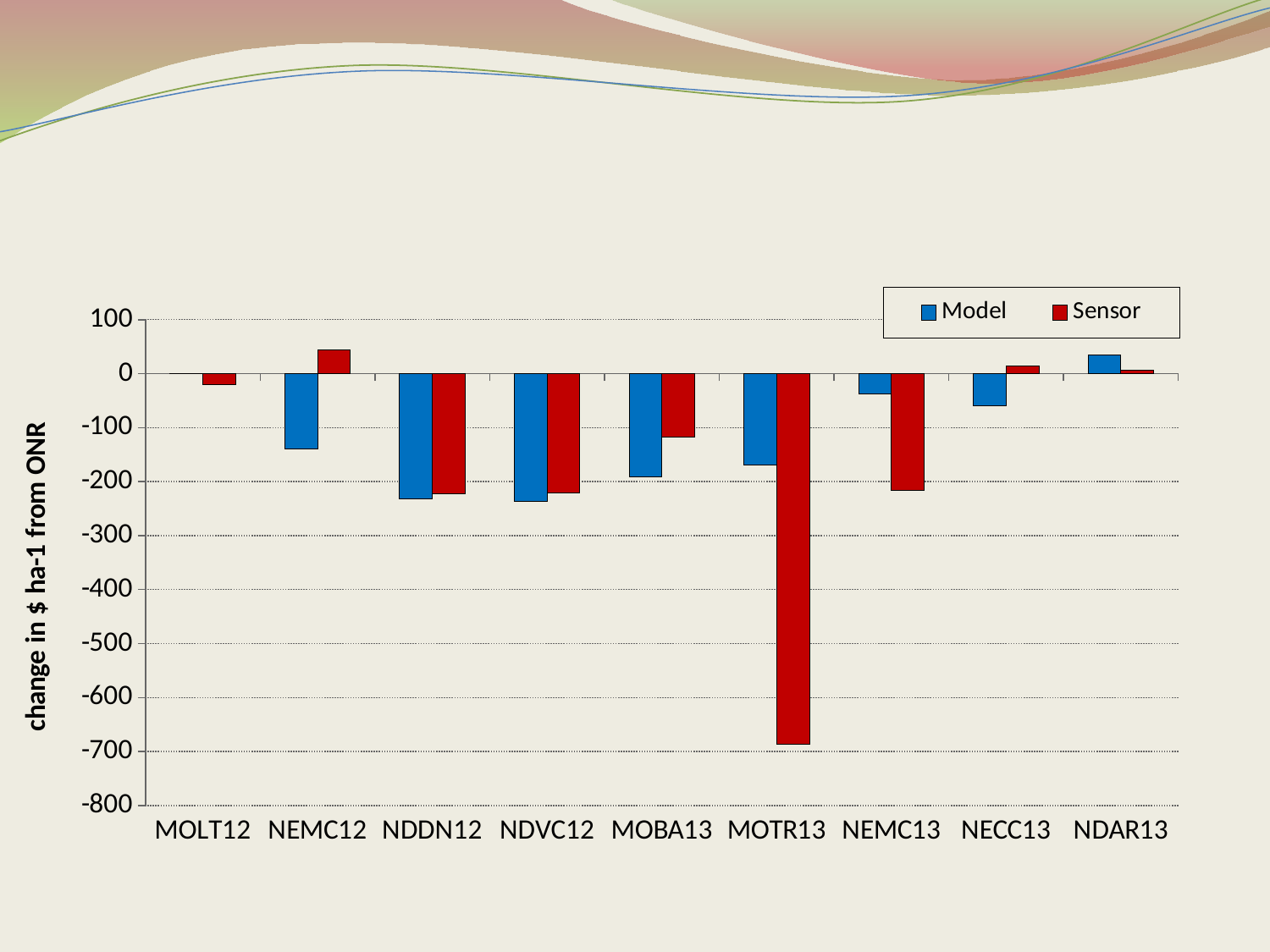
What is the label on the vertical axis? change in $ ha-1 from ONR Which category has the lowest Sensor value? MOTR13 For MOTR13, which is larger, the Model value or the Sensor value? Model How many categories are shown on the x axis? 9 Is the Model value for NEMC12 greater or less than -100? less Is the Sensor value for MOTR13 greater or less than -600? less Which category has the highest Model value? NDAR13 What kind of chart is shown on the slide? bar chart Which category has the highest Sensor value? NEMC12 How many series does the legend list? 2 Is the Sensor value for MOBA13 greater or less than -200? greater For NEMC12, which is larger, the Model value or the Sensor value? Sensor